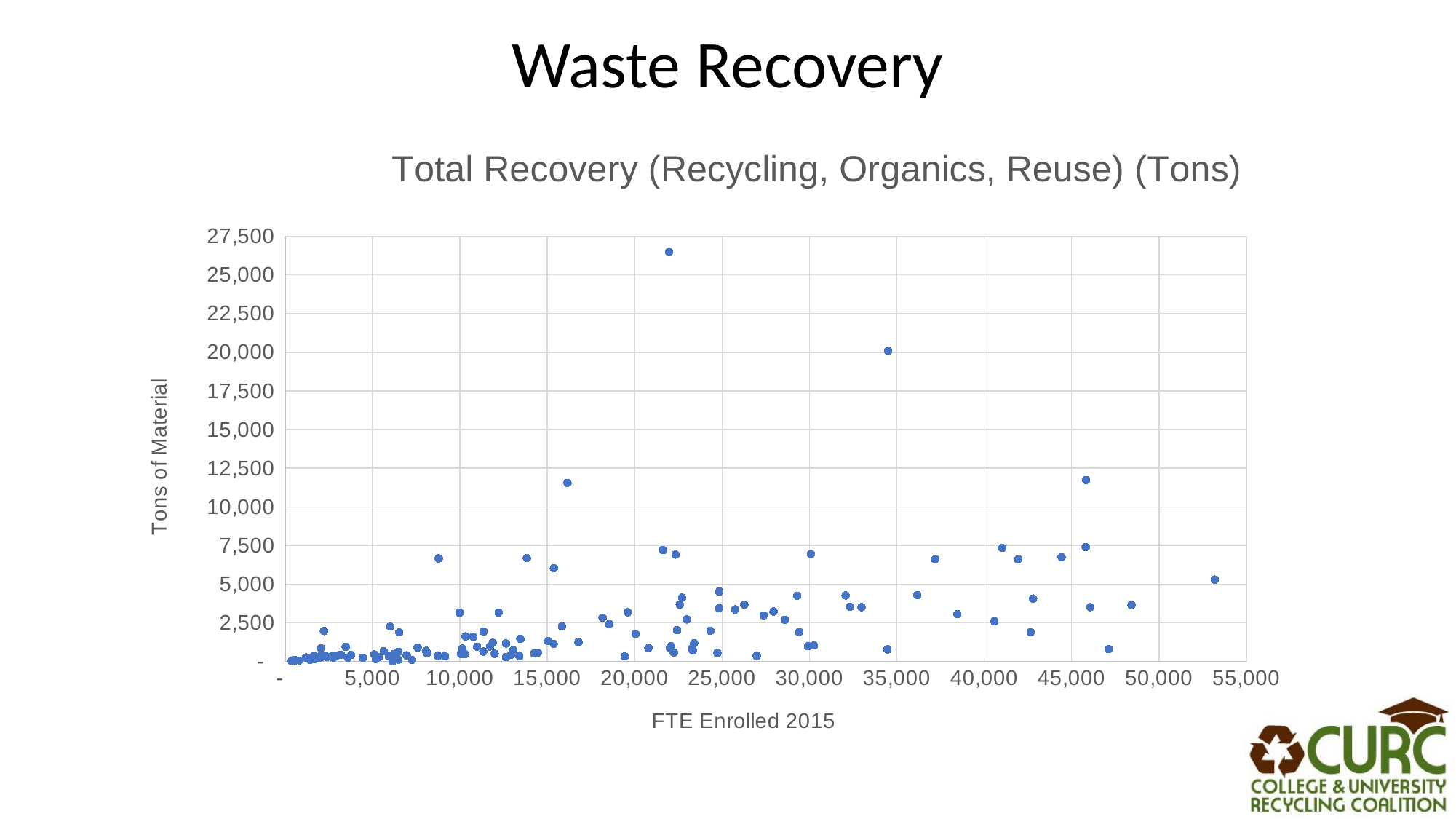
Is the second-highest point on the chart (near 35,000 FTE) greater or less than 22,500 tons? less What kind of chart is shown on the slide? Scatter chart What is the highest value shown on the y axis of the chart? 27,500 Is the second-highest point on the chart (near 35,000 FTE) greater or less than 17,500 tons? greater Is the rightmost point on the chart (beyond 50,000 FTE) greater or less than 7,500 tons? less What is the title of the chart? Total Recovery (Recycling, Organics, Reuse) (Tons) What is the label of the x axis of the chart? FTE Enrolled 2015 Which is larger: the tons of material for the highest point near 22,000 FTE or for the highest point near 35,000 FTE? The point near 22,000 FTE